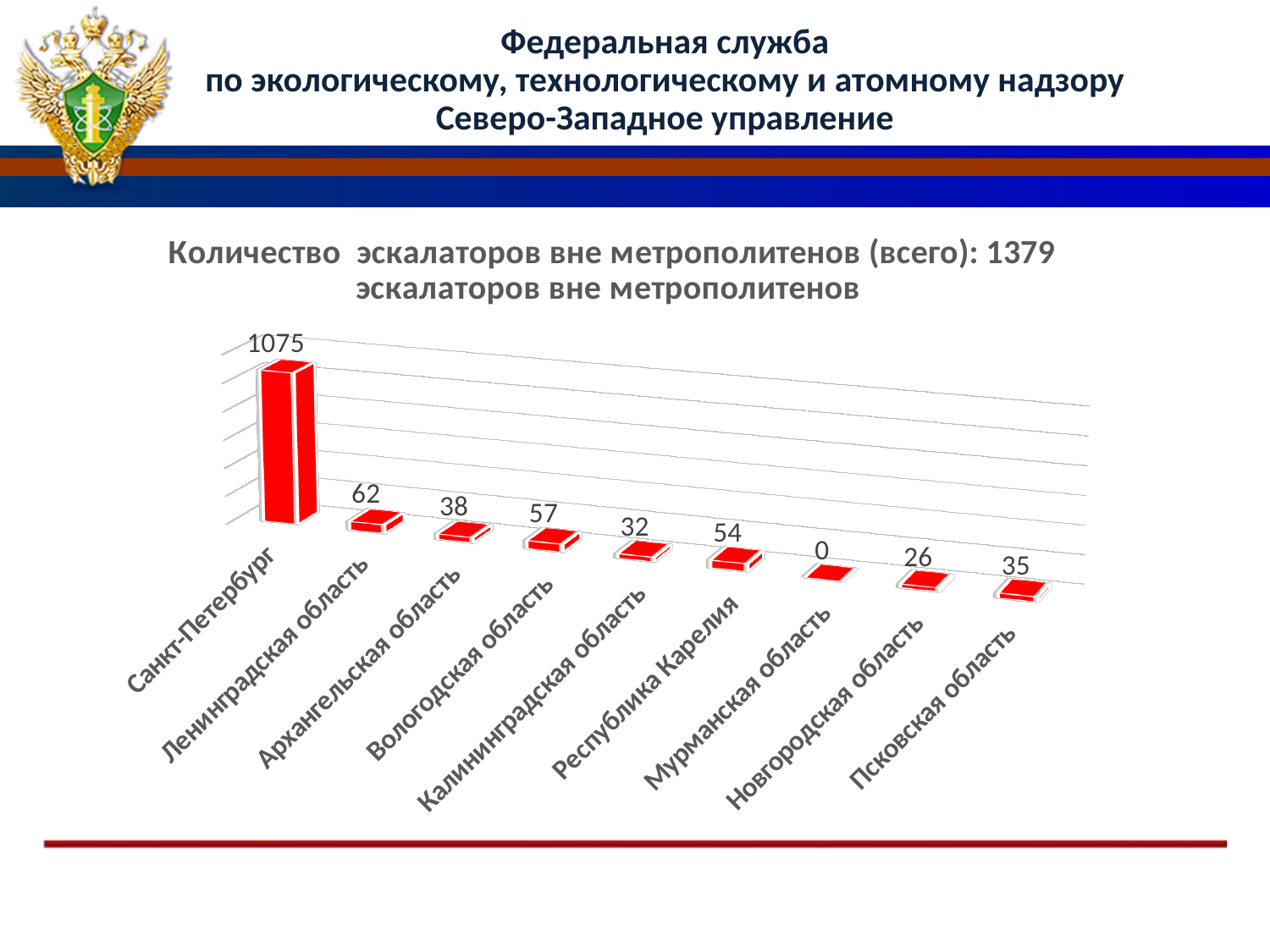
What is the value for Санкт-Петербург? 1075 What is the value for Новгородская область? 26 Which category has the lowest value? Мурманская область Which is larger, the value for Республика Карелия or the value for Калининградская область? Республика Карелия What is the difference between the values for Ленинградская область and Архангельская область? 24 What total number of escalators outside metros is stated in the chart title? 1379 What is the value for Вологодская область? 57 What kind of chart is shown on the slide? bar chart How many categories are shown on the x axis? 9 What is the value for Мурманская область? 0 Which category has the highest value? Санкт-Петербург What colour are the bars in the chart? red